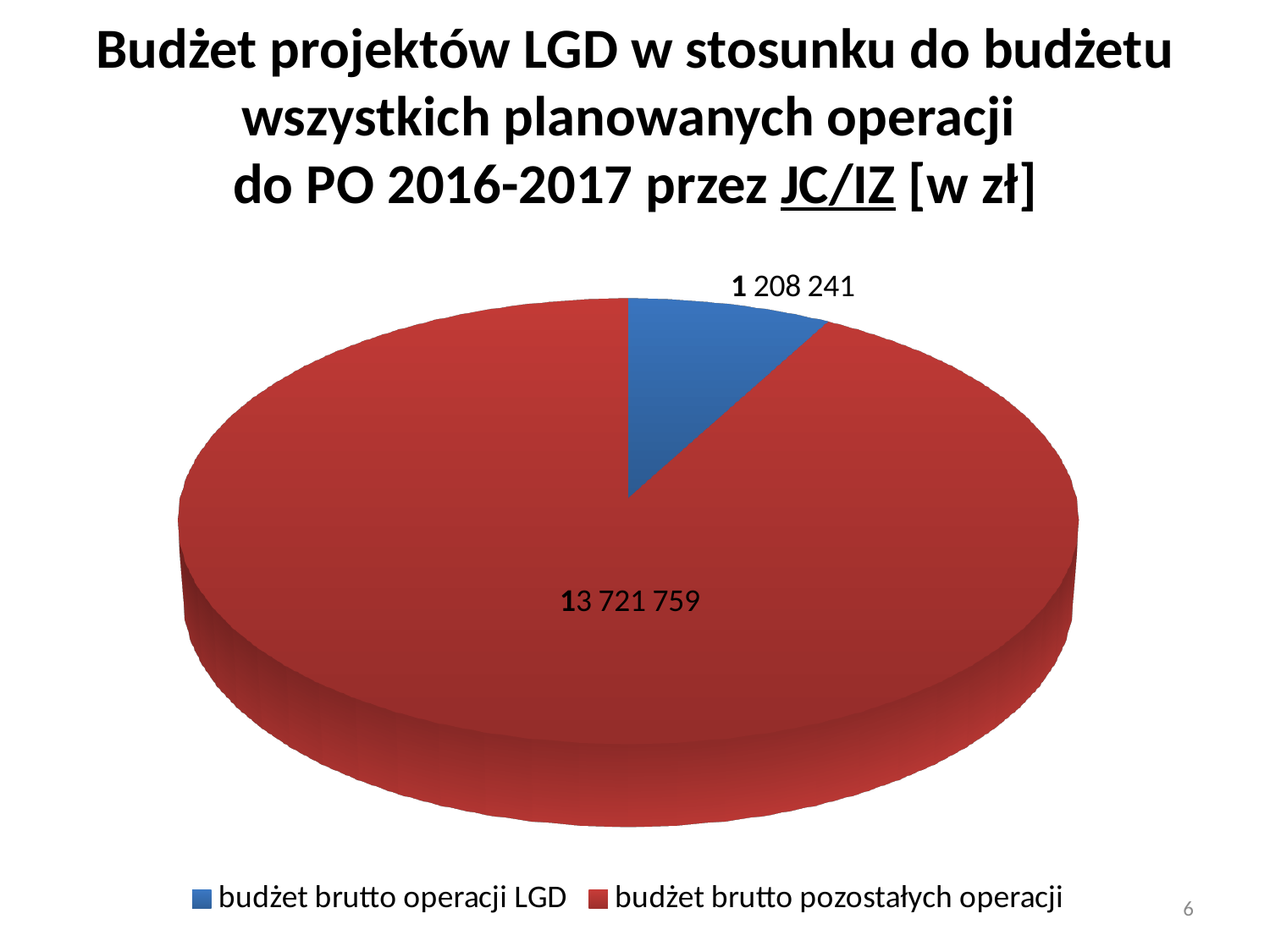
How many slices does the pie chart have? 2 What colour is the slice for budżet brutto operacji LGD? blue What is the value for budżet brutto pozostałych operacji? 13 721 759 What is the total of the two slices in the pie chart? 14 930 000 What kind of chart is shown on the slide? pie chart Which is larger: budżet brutto operacji LGD or budżet brutto pozostałych operacji? budżet brutto pozostałych operacji How many entries does the legend list? 2 Which category has the largest slice of the pie? budżet brutto pozostałych operacji What share of the pie does budżet brutto operacji LGD represent, to the nearest whole percent? 8% What is the value for budżet brutto operacji LGD? 1 208 241 What is the difference between budżet brutto pozostałych operacji and budżet brutto operacji LGD? 12 513 518 Which category has the smallest slice of the pie? budżet brutto operacji LGD